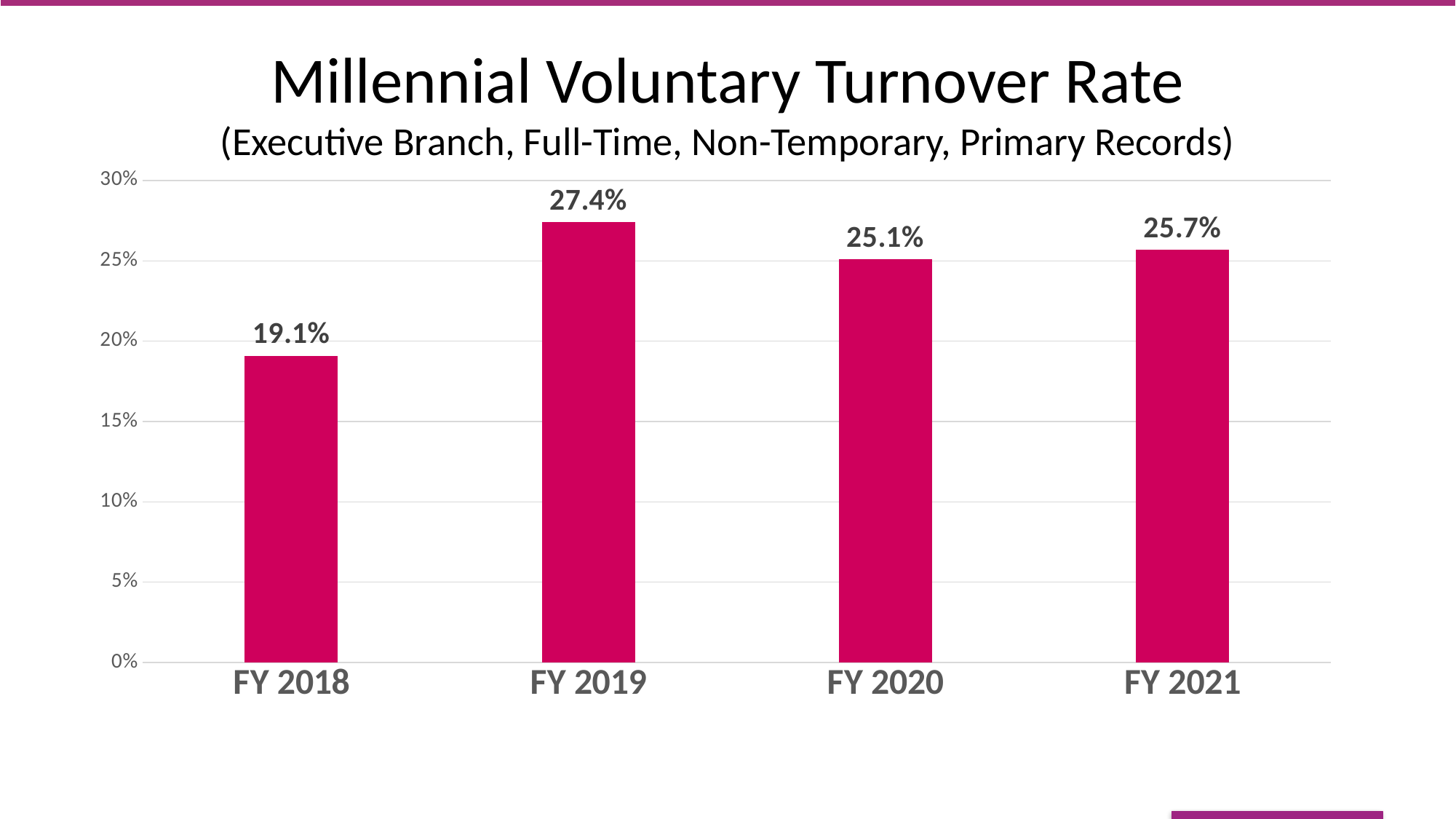
Which has a higher turnover rate, FY 2020 or FY 2021? FY 2021 What type of chart is shown on the slide? Bar chart What is the Millennial voluntary turnover rate for FY 2019? 27.4% What is the Millennial voluntary turnover rate for FY 2020? 25.1% What is the difference in turnover rate between FY 2021 and FY 2020? 0.6% Which fiscal year has the highest Millennial voluntary turnover rate? FY 2019 Is the turnover rate for FY 2018 greater or less than 20%? less How many fiscal years are shown on the chart? 4 What is the difference in turnover rate between FY 2019 and FY 2018? 8.3% What is the Millennial voluntary turnover rate for FY 2018? 19.1% Which fiscal year has the lowest Millennial voluntary turnover rate? FY 2018 What is the Millennial voluntary turnover rate for FY 2021? 25.7%